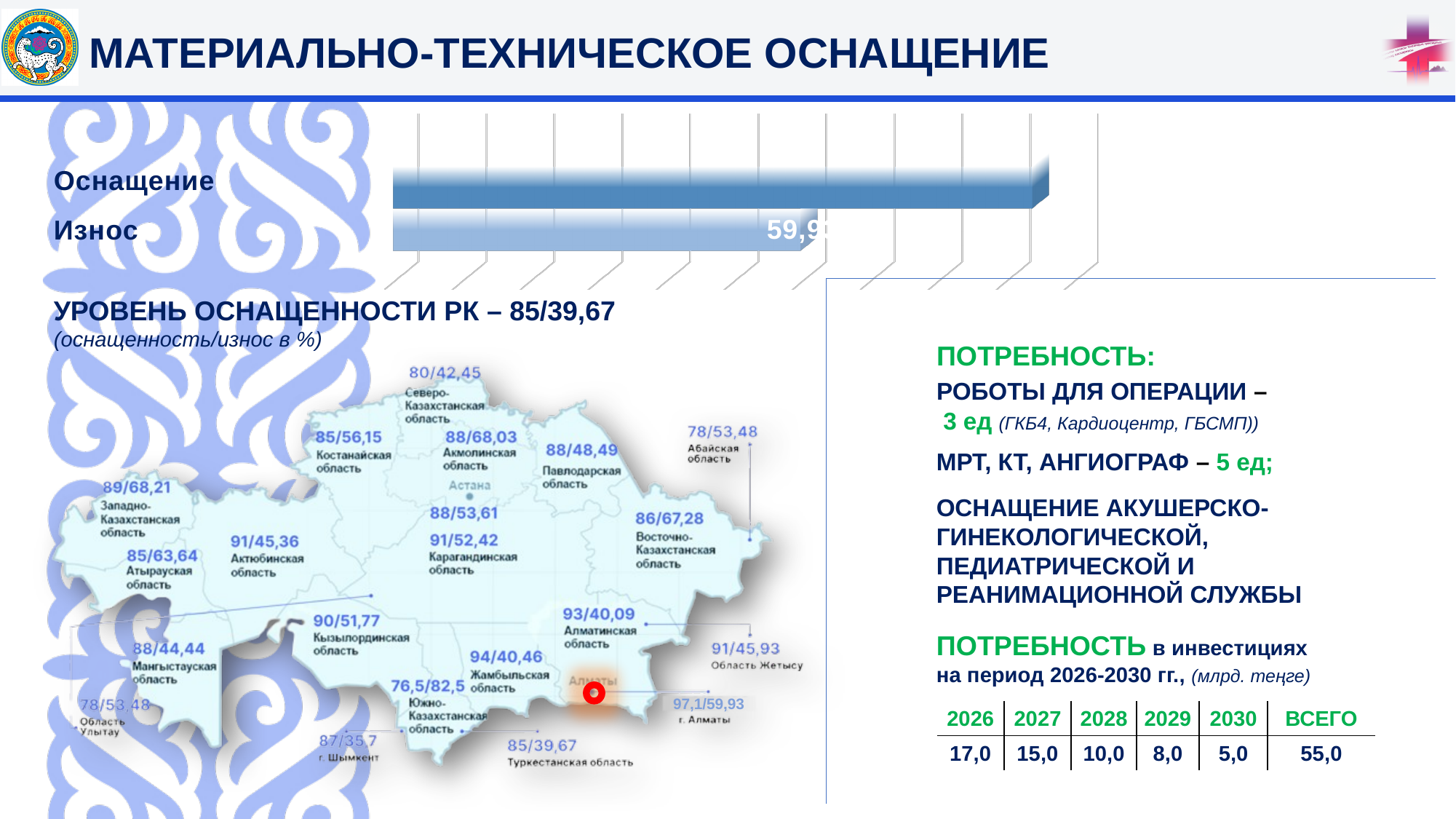
How many bars does the chart at the top of the slide have? 2 Which category has the shortest bar in the chart at the top of the slide? Износ In the chart at the top of the slide, which bar is longer: Оснащение or Износ? Оснащение What are the two category labels on the chart at the top of the slide? Оснащение and Износ Are the bars in the chart at the top of the slide horizontal or vertical? horizontal Which category has the longest bar in the chart at the top of the slide? Оснащение What kind of chart is shown at the top of the slide? bar chart